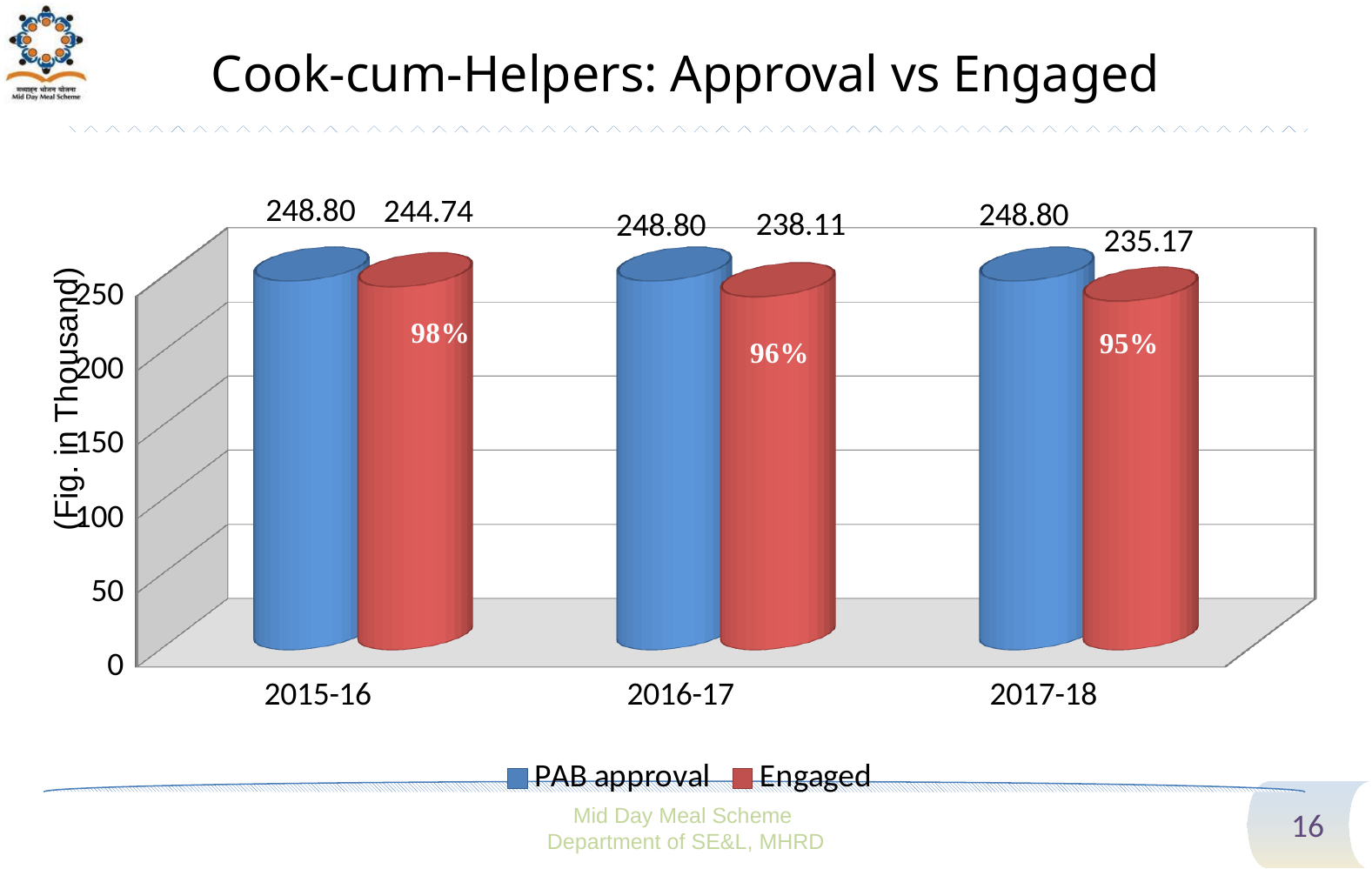
How many series does the legend list? 2 How many years are shown on the x axis? 3 What kind of chart is shown on the slide? Bar chart What is the Engaged value for 2016-17? 238.11 What percentage label is shown on the Engaged bar for 2015-16? 98% Which year has the highest Engaged value? 2015-16 What is the difference between PAB approval and Engaged in 2017-18? 13.63 Which is larger in 2016-17, PAB approval or Engaged? PAB approval What is the Engaged value for 2017-18? 235.17 Do the Engaged values rise or fall from 2015-16 to 2017-18? Fall Which year has the lowest Engaged value? 2017-18 What is the PAB approval value for 2015-16? 248.80